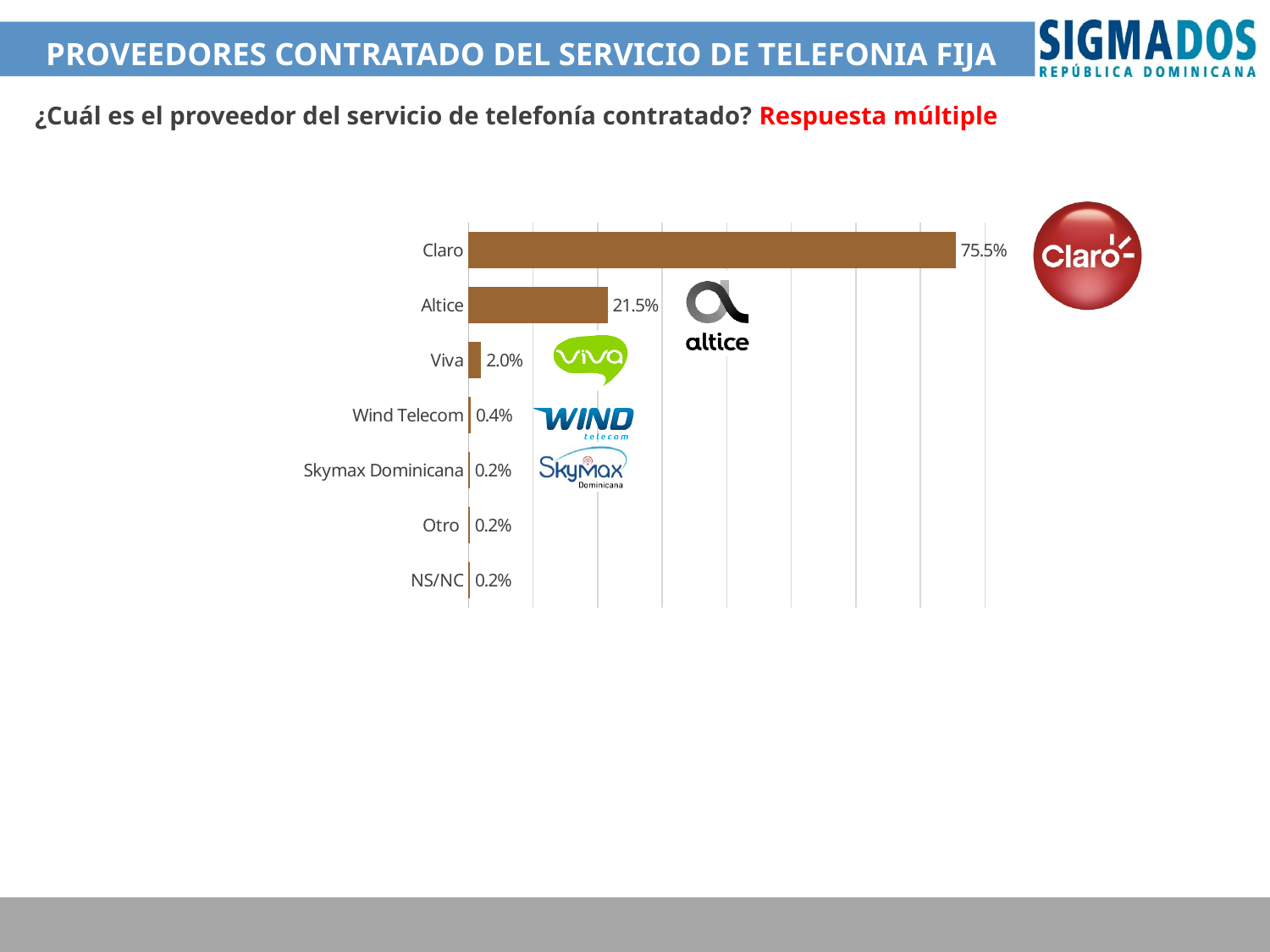
What is the value for Viva? 2.0% What is the difference between the values for Viva and Wind Telecom? 1.6% What is the value for Claro? 75.5% What is the difference between the values for Claro and Altice? 54.0% What is the title of the slide? PROVEEDORES CONTRATADO DEL SERVICIO DE TELEFONIA FIJA Which provider has the highest value? Claro What is the value for Skymax Dominicana? 0.2% What is the value for Wind Telecom? 0.4% How many categories are shown in the chart? 7 What kind of chart is shown on the slide? Bar chart What is the value for Altice? 21.5% Which is larger, the value for Altice or the value for Viva? Altice